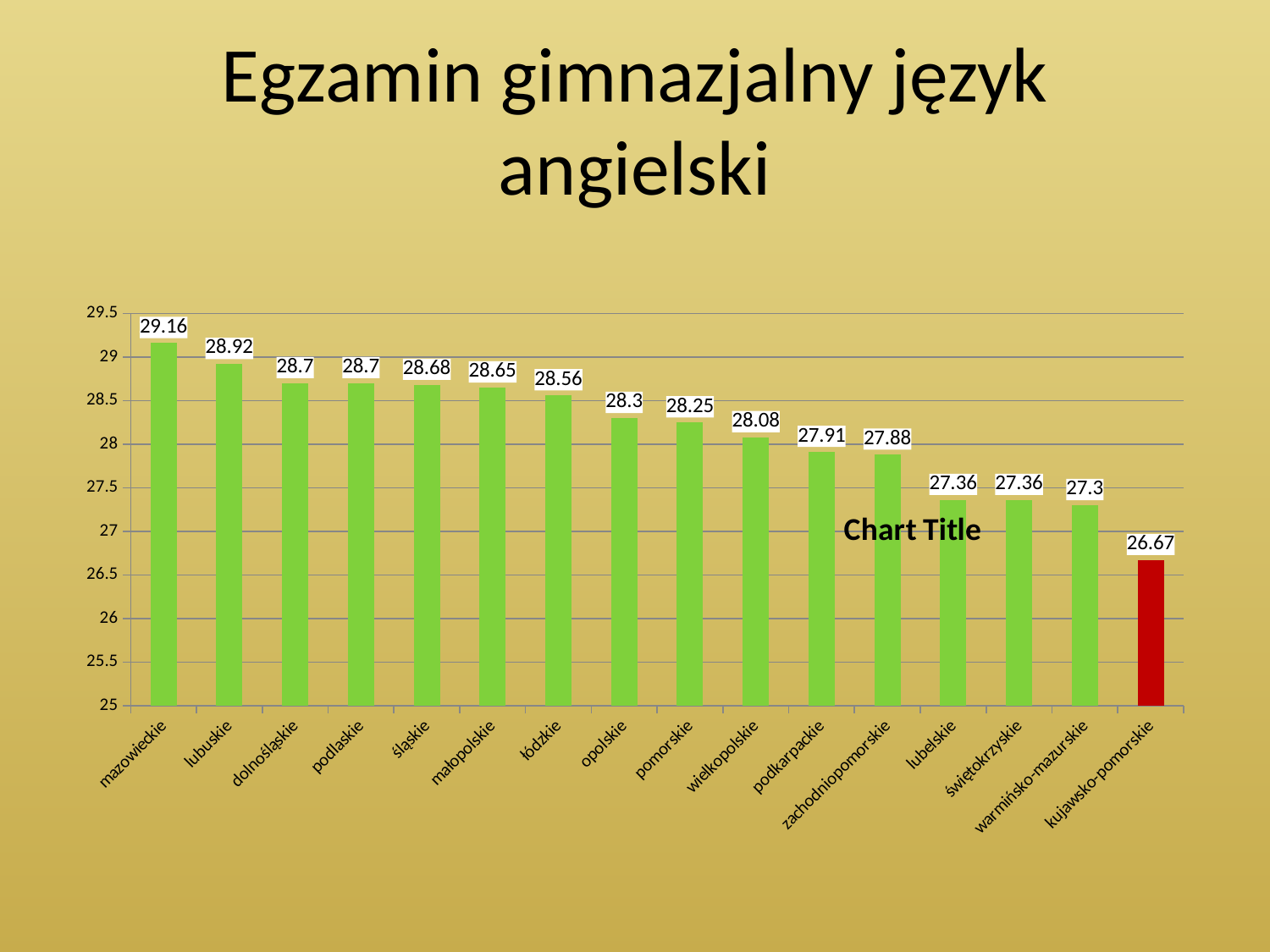
What kind of chart is shown on the slide? bar chart Which category has the lowest value? kujawsko-pomorskie What is the value for mazowieckie? 29.16 What is the value for kujawsko-pomorskie? 26.67 Is the value for wielkopolskie greater or less than 28? greater Which is larger, the value for lubuskie or the value for pomorskie? lubuskie Do the values rise or fall from left to right along the x axis? fall How many categories are shown on the x axis? 16 Which category has the highest value? mazowieckie Which bar is shown in a different colour (red) from the others? kujawsko-pomorskie What is the difference between the values for mazowieckie and kujawsko-pomorskie? 2.49 What is the value for opolskie? 28.3